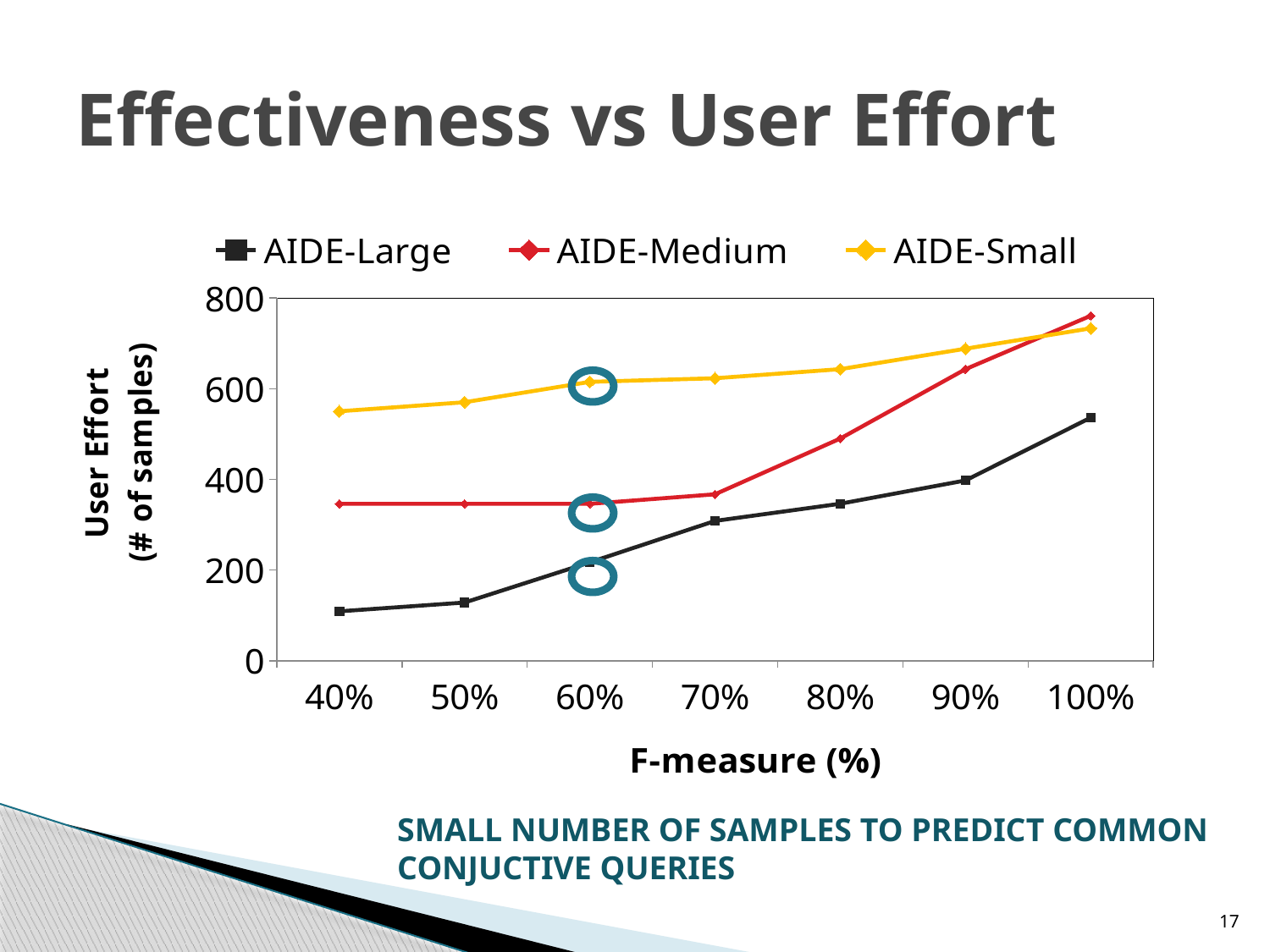
Which series has the highest user effort at 40% F-measure? AIDE-Small Is the AIDE-Small value at 40% F-measure greater or less than 600? less What kind of chart is shown on the slide? line chart What is the title of the x axis? F-measure (%) Which series has the lowest user effort at 100% F-measure? AIDE-Large How many F-measure values are plotted along the x axis? 7 Is the AIDE-Medium value at 100% F-measure greater or less than 600? greater At 60% F-measure, which series has the larger user effort, AIDE-Large or AIDE-Medium? AIDE-Medium How many series does the legend list? 3 Is the AIDE-Large value at 40% F-measure greater or less than 200? less Does the AIDE-Large line rise or fall as F-measure increases from 40% to 100%? rise